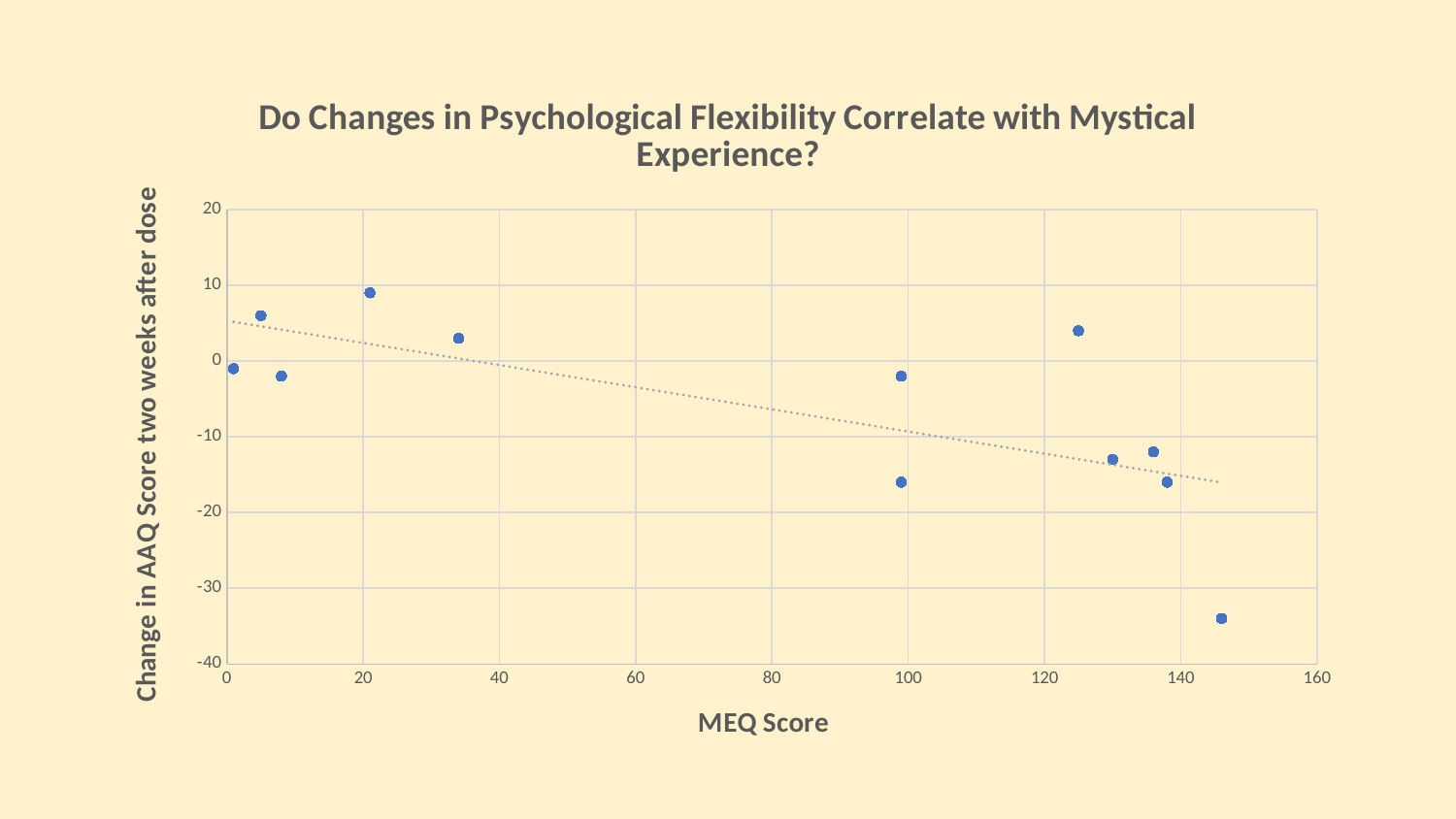
What is the label of the x axis? MEQ Score How many points have an MEQ Score greater than 100? 5 What kind of chart is shown on the slide? Scatter plot Which has the lower y value: the point with the highest MEQ Score or the point with the lowest MEQ Score? The point with the highest MEQ Score How many points have a change in AAQ Score greater than 0? 4 Is the y value of the lowest point on the chart greater or less than -30? less Does the dotted trend line rise or fall as MEQ Score increases? Fall Is the y value of the highest point on the chart greater or less than 0? greater Is the y value of the point with the highest MEQ Score greater or less than -20? less What is the maximum value shown on the x axis? 160 What is the title of the chart? Do Changes in Psychological Flexibility Correlate with Mystical Experience? How many data points are plotted on the chart? 12